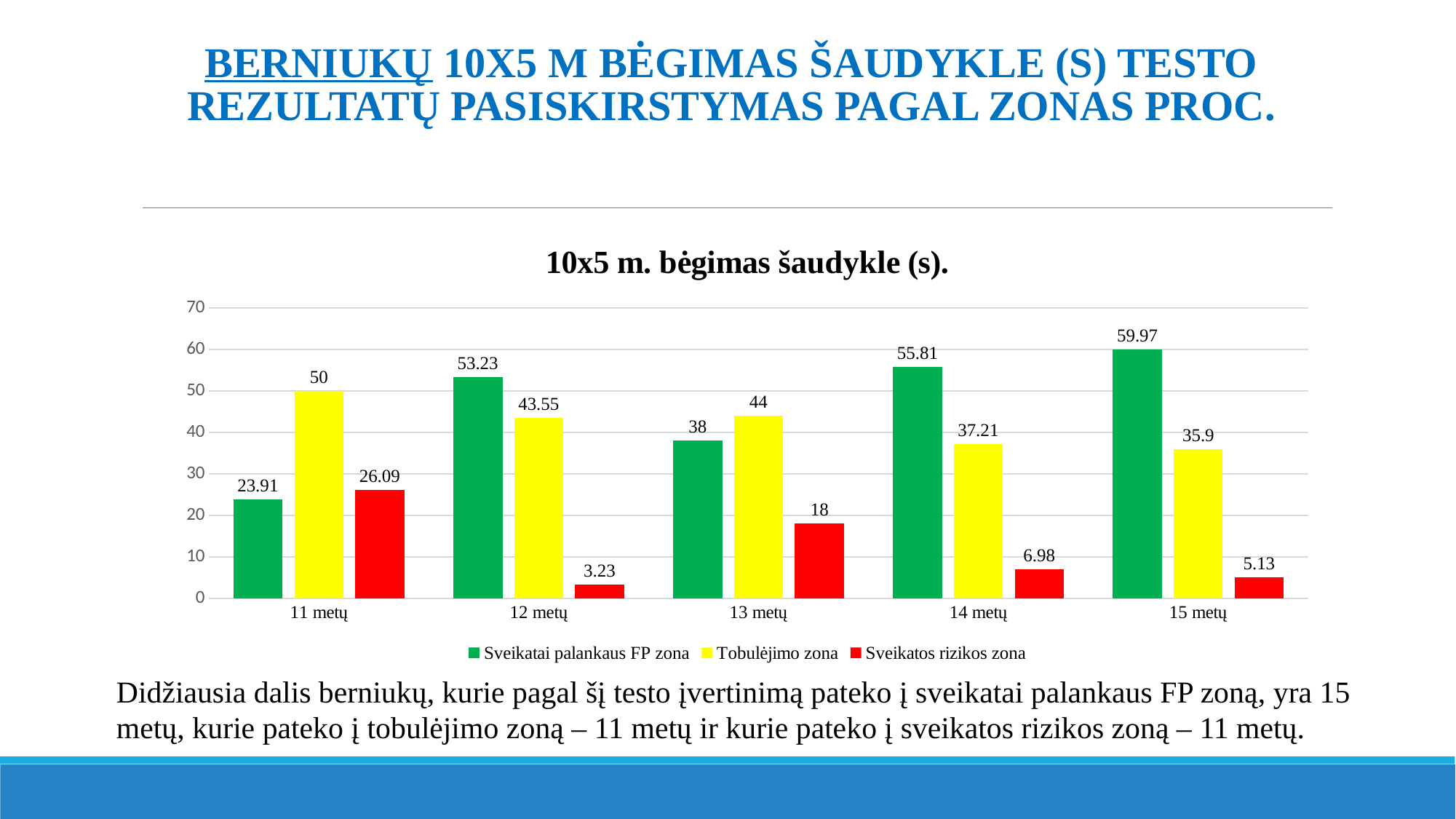
Which age group has the highest value for Tobulėjimo zona? 11 metų What is the value for Sveikatos rizikos zona at 13 metų? 18 How many series does the legend list? 3 Which is larger at 13 metų: Sveikatai palankaus FP zona or Tobulėjimo zona? Tobulėjimo zona What is the value for Tobulėjimo zona at 12 metų? 43.55 Which age group has the lowest value for Sveikatos rizikos zona? 12 metų What is the value for Sveikatai palankaus FP zona at 15 metų? 59.97 What kind of chart is shown on the slide? Bar chart What is the difference between the Sveikatai palankaus FP zona values at 15 metų and 11 metų? 36.06 Does the Sveikatos rizikos zona value rise or fall from 11 metų to 12 metų? Fall Which age group has the highest value for Sveikatai palankaus FP zona? 15 metų How many age groups are shown on the x axis? 5